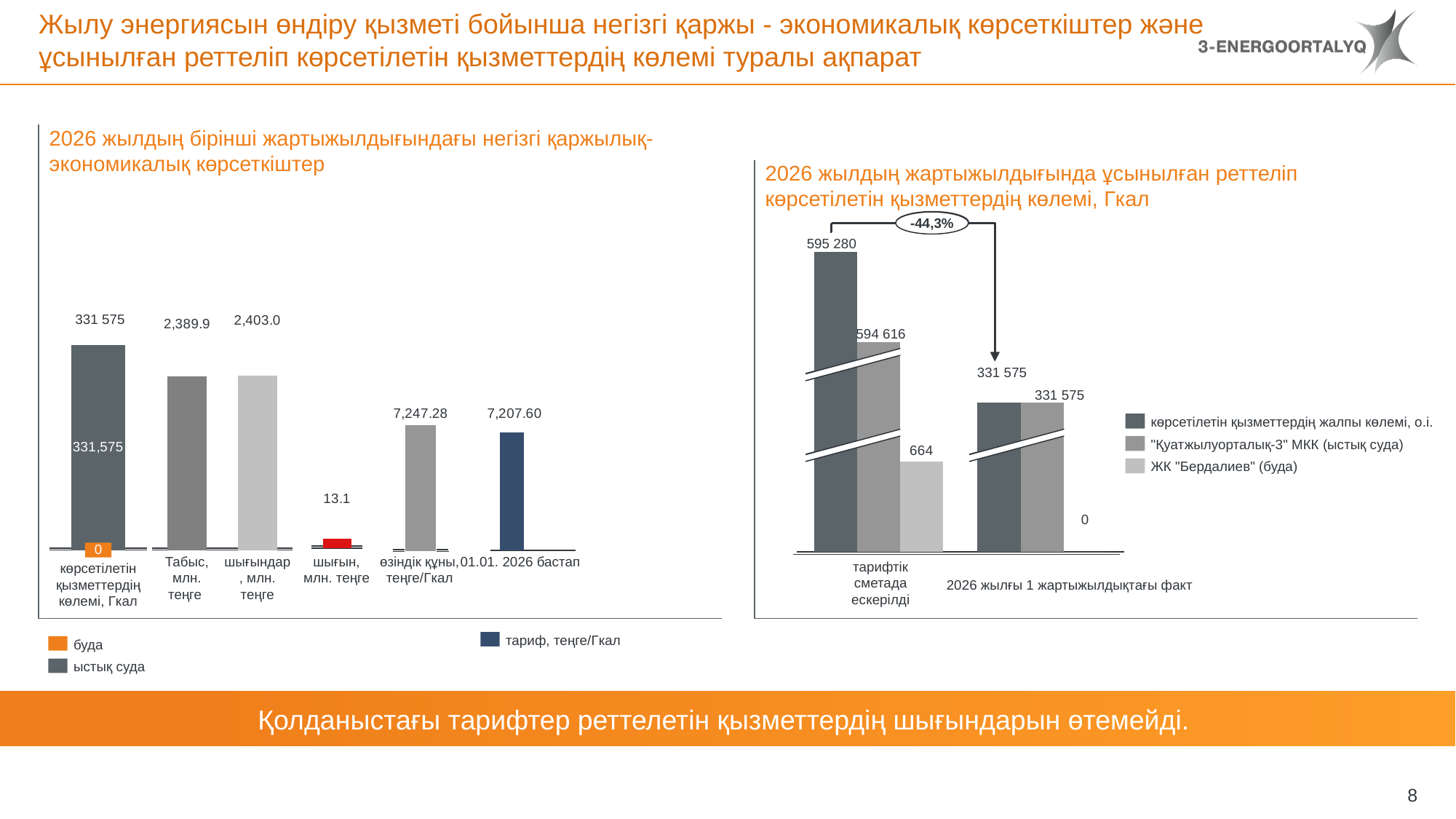
In the left chart, what is the value for шығын, млн. теңге? 13.1 In the left chart, what is the value for Табыс, млн. теңге? 2,389.9 In the right chart, what is the total volume (көрсетілетін қызметтердің жалпы көлемі) for тарифтік сметада ескерілді? 595 280 In the left chart, what is the difference between өзіндік құны (7,247.28) and the tariff (7,207.60)? 39.68 In the left chart, which is larger: Табыс or шығындар? шығындар In the right chart, what is the value for ЖК "Бердалиев" (буда) in тарифтік сметада ескерілді? 664 In the right chart, what is the value for ЖК "Бердалиев" (буда) in 2026 жылғы 1 жартыжылдықтағы факт? 0 In the right chart, how many series does the legend list? 3 In the right chart, what percentage change is shown between the planned and actual total volume? -44,3% In the left chart, what is the value for өзіндік құны, теңге/Гкал? 7,247.28 In the left chart, what is the value for шығындар, млн. теңге? 2,403.0 In the left chart, what is the tariff value (тариф, теңге/Гкал) from 01.01.2026? 7,207.60